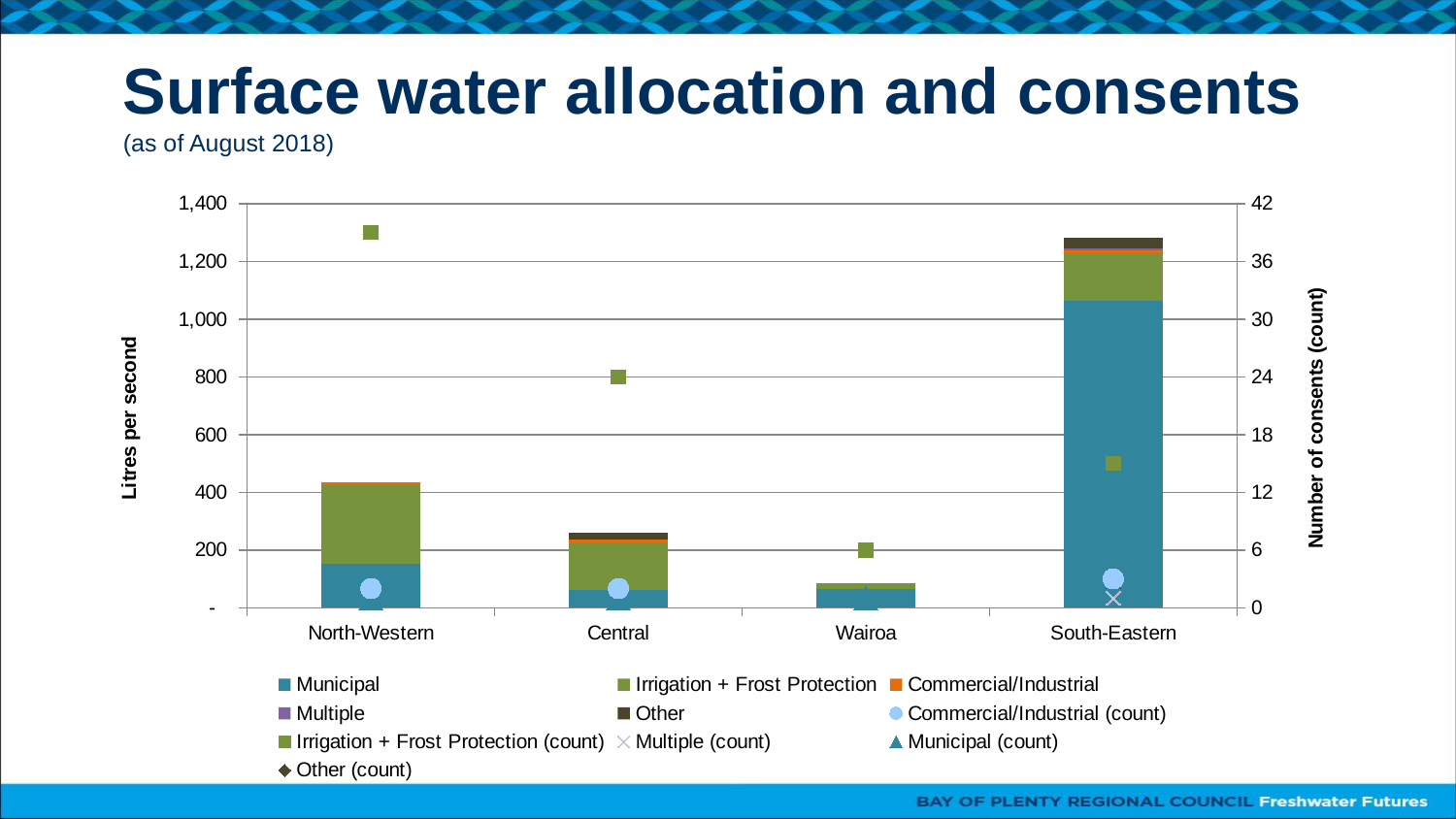
Is the Irrigation + Frost Protection (count) marker for North-Western greater or less than 36 consents? greater Which has the larger total stacked bar, North-Western or Central? North-Western What kind of chart is shown on the slide? bar chart How many series does the legend list? 10 Is the total stacked bar for North-Western greater or less than 400 litres per second? greater Which category has the shortest stacked bar (litres per second)? Wairoa Which category has the tallest stacked bar (litres per second)? South-Eastern Is the total stacked bar for South-Eastern greater or less than 1,200 litres per second? greater What is the title of the left vertical axis? Litres per second How many categories are shown on the x axis? 4 What is the title of the right vertical axis? Number of consents (count)